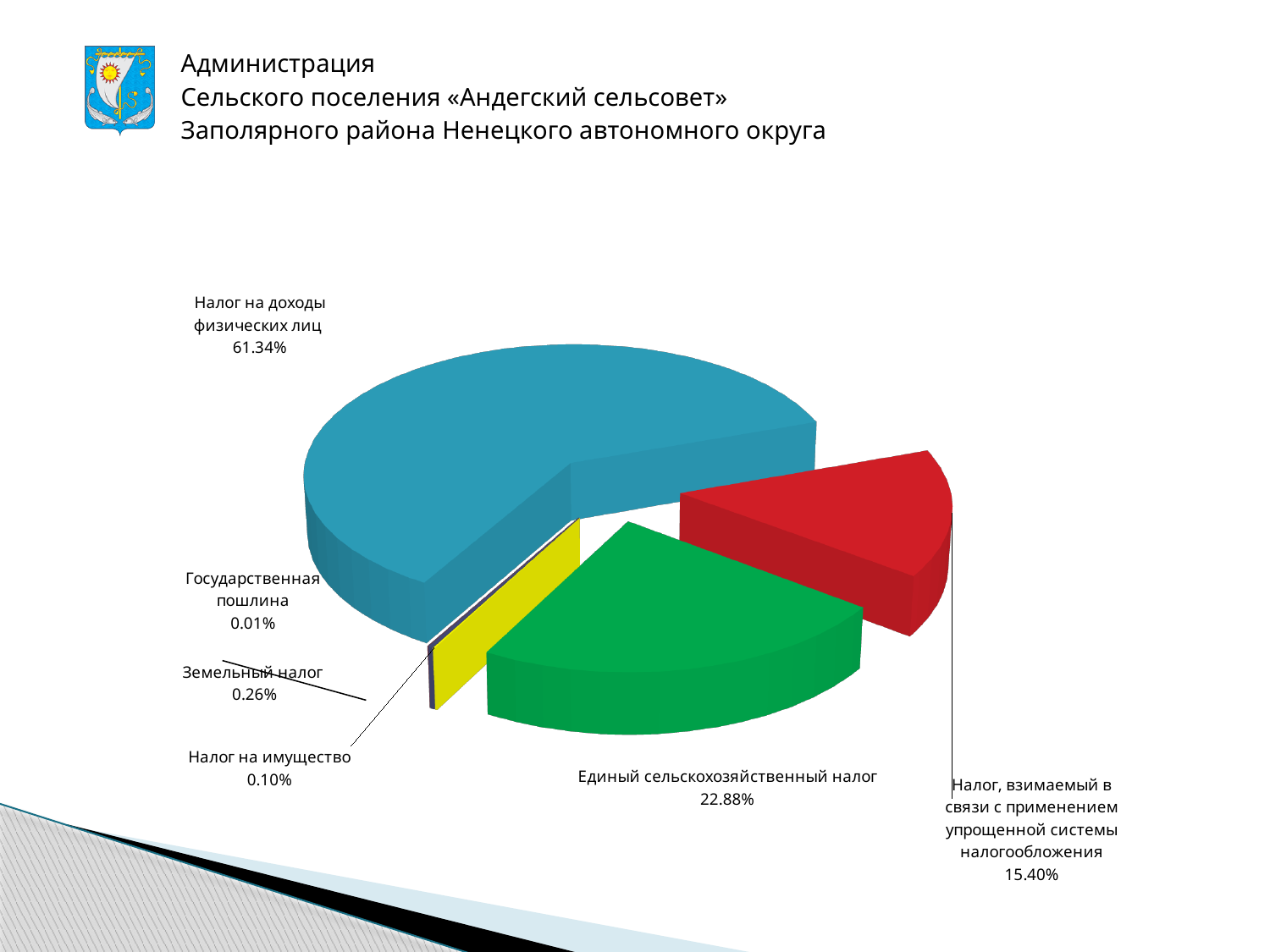
What share of the pie does "Земельный налог" have? 0.26% What share of the pie does "Единый сельскохозяйственный налог" have? 22.88% What share of the pie does "Государственная пошлина" have? 0.01% Which is larger: the share for "Единый сельскохозяйственный налог" or the share for "Налог, взимаемый в связи с применением упрощенной системы налогообложения"? Единый сельскохозяйственный налог What share of the pie does "Налог, взимаемый в связи с применением упрощенной системы налогообложения" have? 15.40% What kind of chart is shown on the slide? Pie chart What is the difference between the shares of "Налог на доходы физических лиц" and "Единый сельскохозяйственный налог"? 38.46% How many slices does the pie chart have? 6 Which category has the largest share of the pie? Налог на доходы физических лиц What colour is the slice for "Единый сельскохозяйственный налог"? Green Which category has the smallest share of the pie? Государственная пошлина What share of the pie does "Налог на доходы физических лиц" have? 61.34%